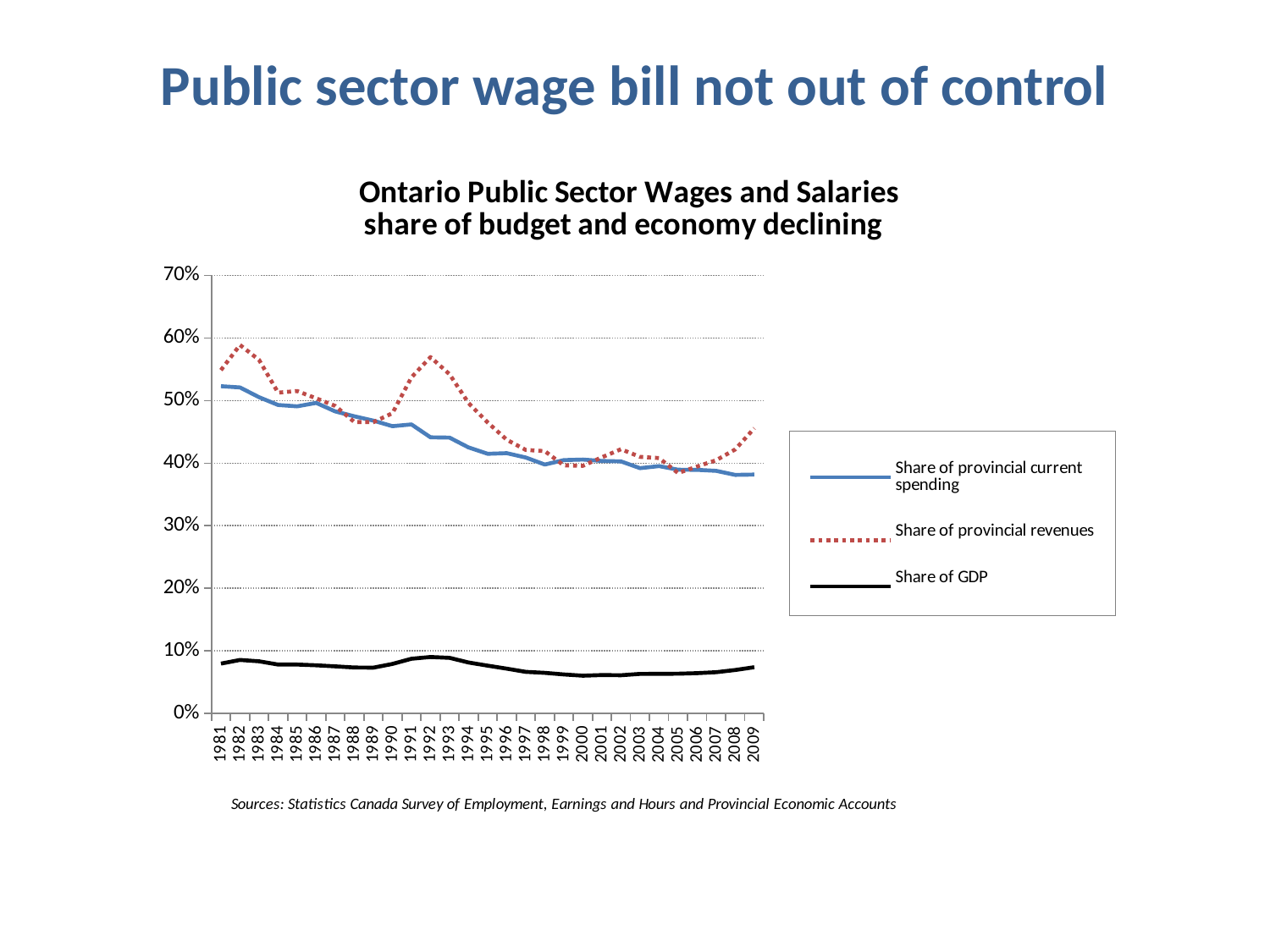
Is the value for Share of provincial revenues in 1992 greater or less than 50%? greater What kind of chart is shown on the slide? line chart In 1982, which is larger: Share of provincial revenues or Share of provincial current spending? Share of provincial revenues How many years are plotted along the x axis? 29 Is the value for Share of provincial revenues in 1982 greater or less than 50%? greater Is the value for Share of GDP in 2009 greater or less than 10%? less In which year is the Share of provincial revenues series at its highest? 1982 Does the Share of provincial current spending series rise or fall from 1981 to 2009? fall In 2009, which is larger: Share of GDP or Share of provincial current spending? Share of provincial current spending How many series does the legend list? 3 Which series is drawn with a dotted line? Share of provincial revenues